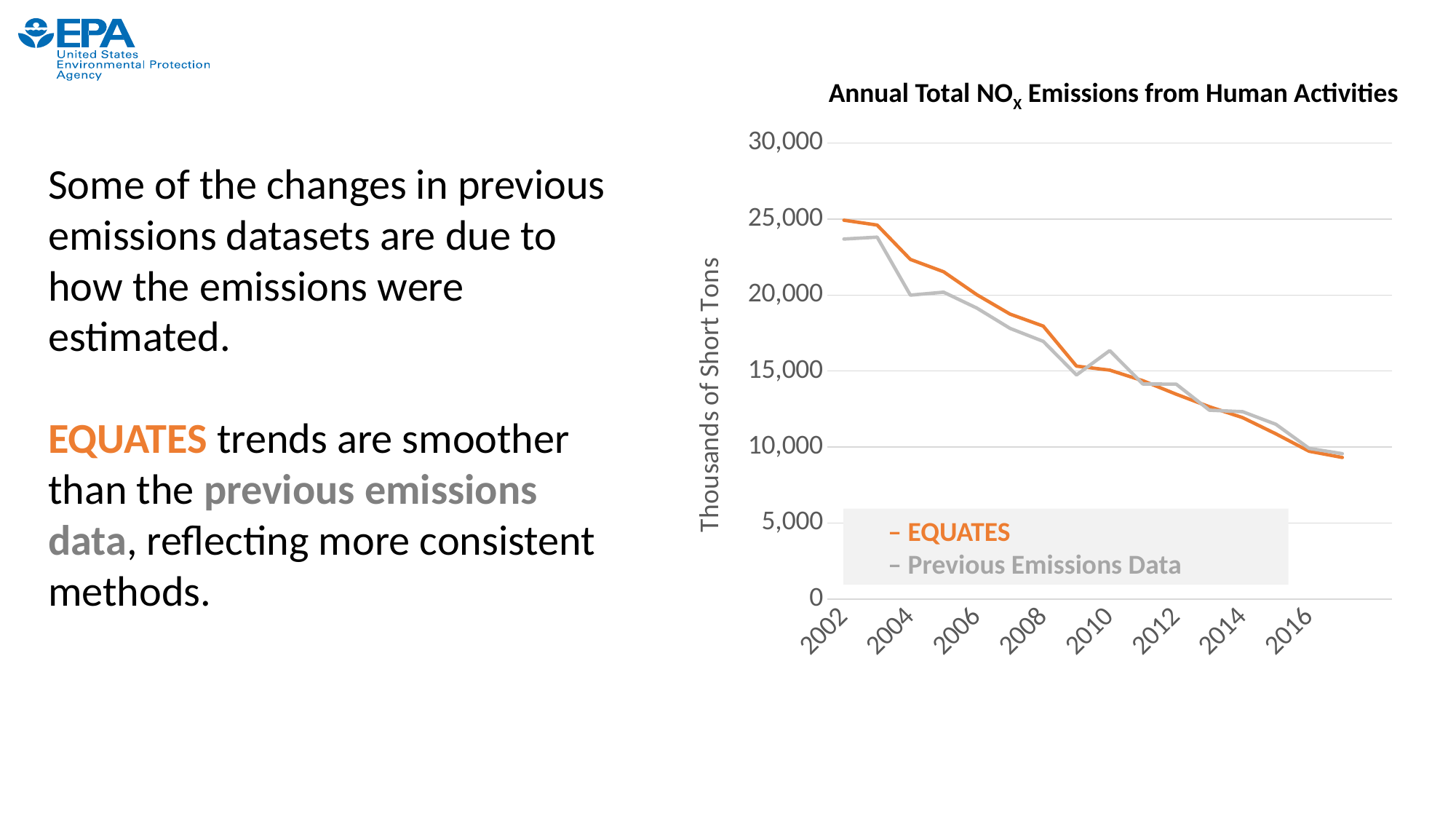
What is the label on the chart's vertical axis? Thousands of Short Tons In 2010, which series has the higher value, EQUATES or Previous Emissions Data? Previous Emissions Data Is the EQUATES value for 2002 greater or less than 20,000? greater In 2004, which series has the higher value, EQUATES or Previous Emissions Data? EQUATES Is the EQUATES value for 2008 greater or less than 15,000? greater What kind of chart is shown on the slide? line chart How many year labels are shown on the chart's horizontal axis? 8 How many series does the chart's legend list? 2 Is the Previous Emissions Data value for 2016 greater or less than 15,000? less What is the title of the chart? Annual Total NOx Emissions from Human Activities Do the EQUATES values rise or fall from 2002 to 2016? fall